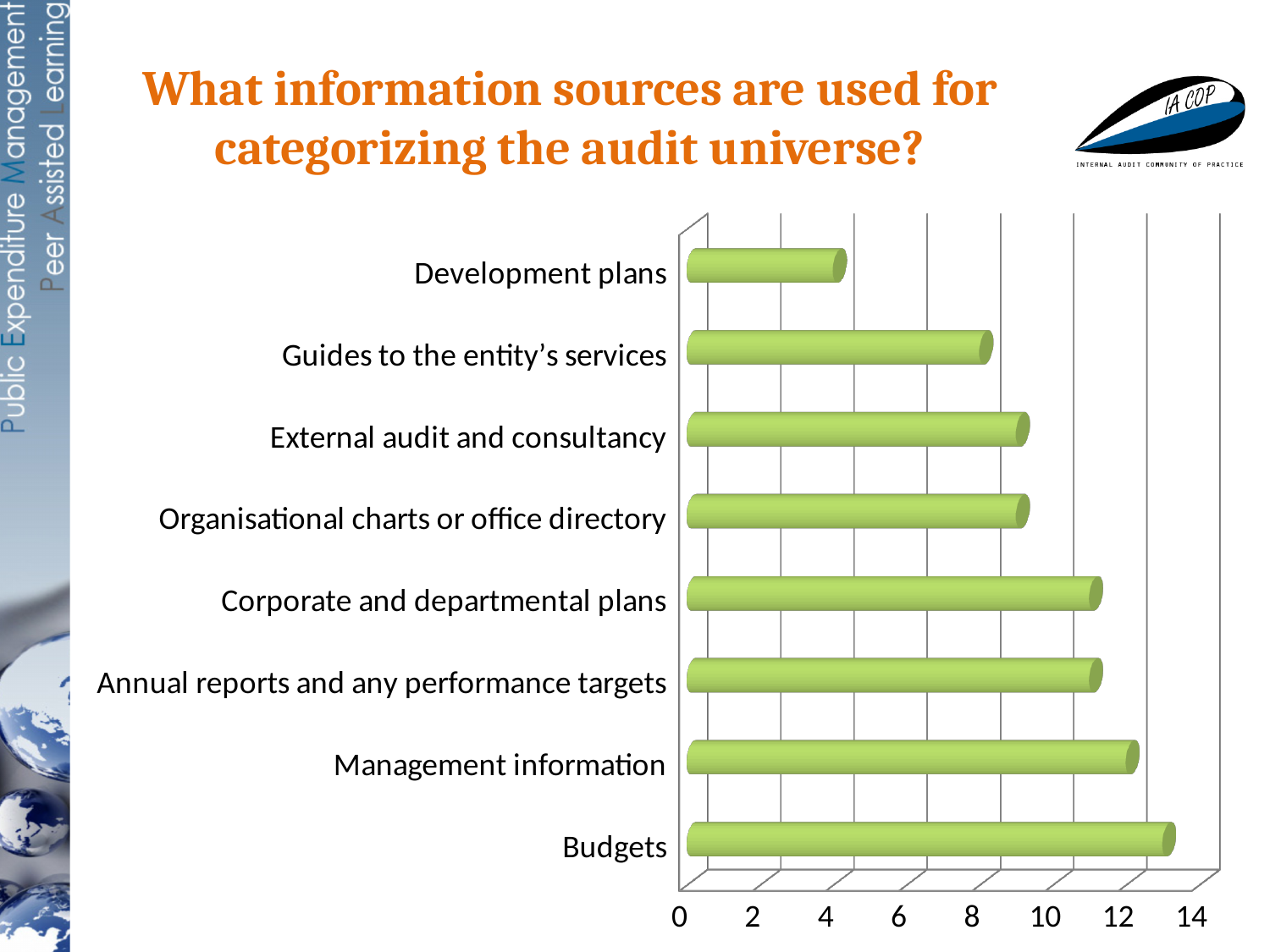
What kind of chart is shown on the slide? Bar chart What is the title of the slide containing the chart? What information sources are used for categorizing the audit universe? Which information source has the highest value in the chart? Budgets Is the value for Development plans greater or less than 6? less Which has a larger value: Budgets or Development plans? Budgets Which has a larger value: Management information or Guides to the entity's services? Management information Is the value for External audit and consultancy greater or less than 10? less How many information sources (categories) are plotted in the chart? 8 Is the value for Guides to the entity's services greater or less than 6? greater Which information source has the lowest value in the chart? Development plans